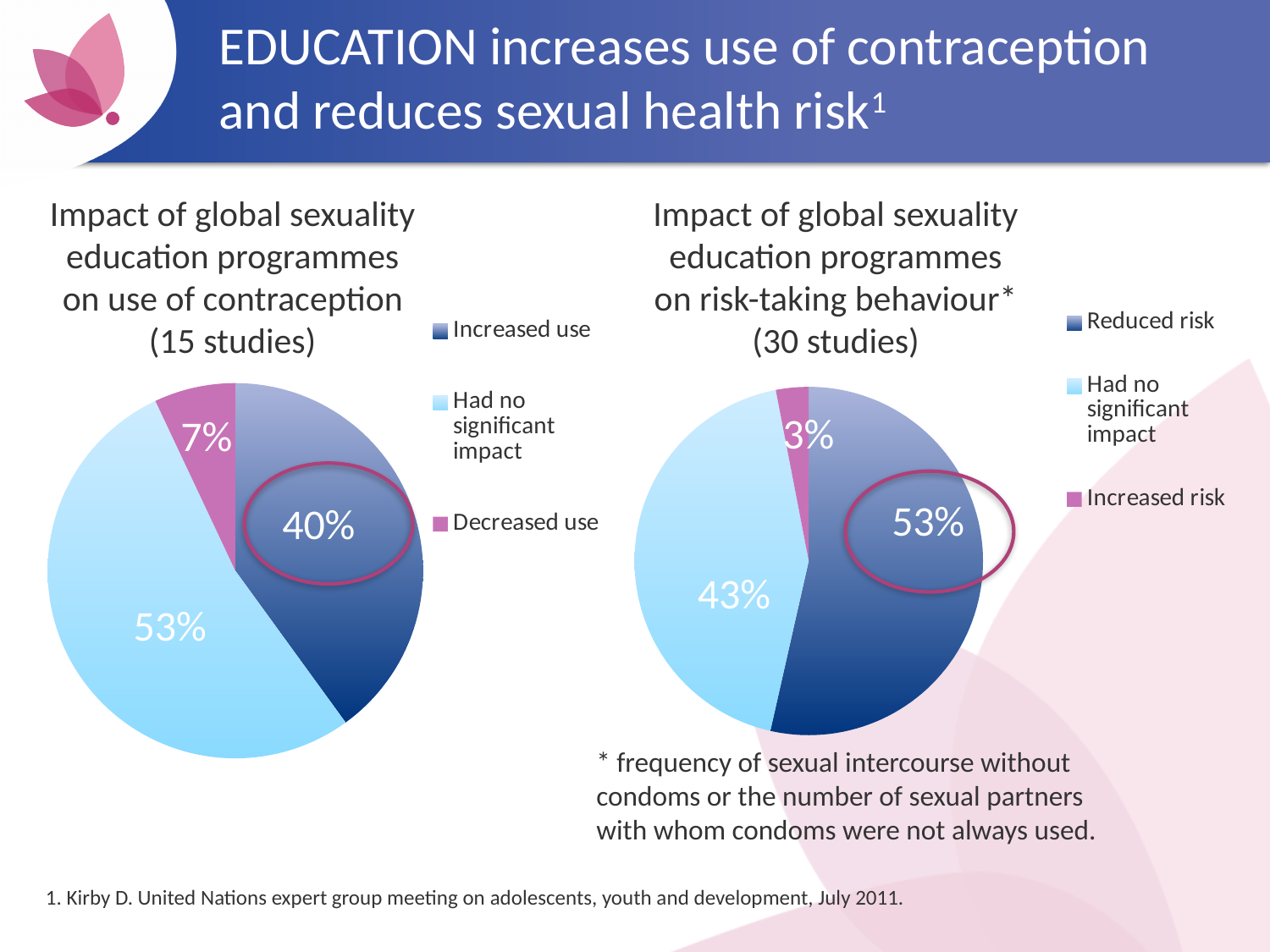
In the right chart on risk-taking behaviour, what share of studies found increased risk? 3% In the left chart on use of contraception, what share of studies had no significant impact? 53% In the left chart on use of contraception, which category has the smallest slice? Decreased use How many studies does the right chart on risk-taking behaviour say it is based on? 30 studies In the left chart on use of contraception, what share of studies found decreased use? 7% In the right chart on risk-taking behaviour, which category has the largest slice? Reduced risk In the left chart on use of contraception, what share of studies found increased use? 40% In the left chart on use of contraception, what is the difference in percentage points between 'Had no significant impact' and 'Increased use'? 13 How many slices does the right chart on risk-taking behaviour have? 3 What type of chart is the left chart on use of contraception? Pie chart In the right chart on risk-taking behaviour, which is larger: 'Reduced risk' or 'Had no significant impact'? Reduced risk In the right chart on risk-taking behaviour, what share of studies found reduced risk? 53%